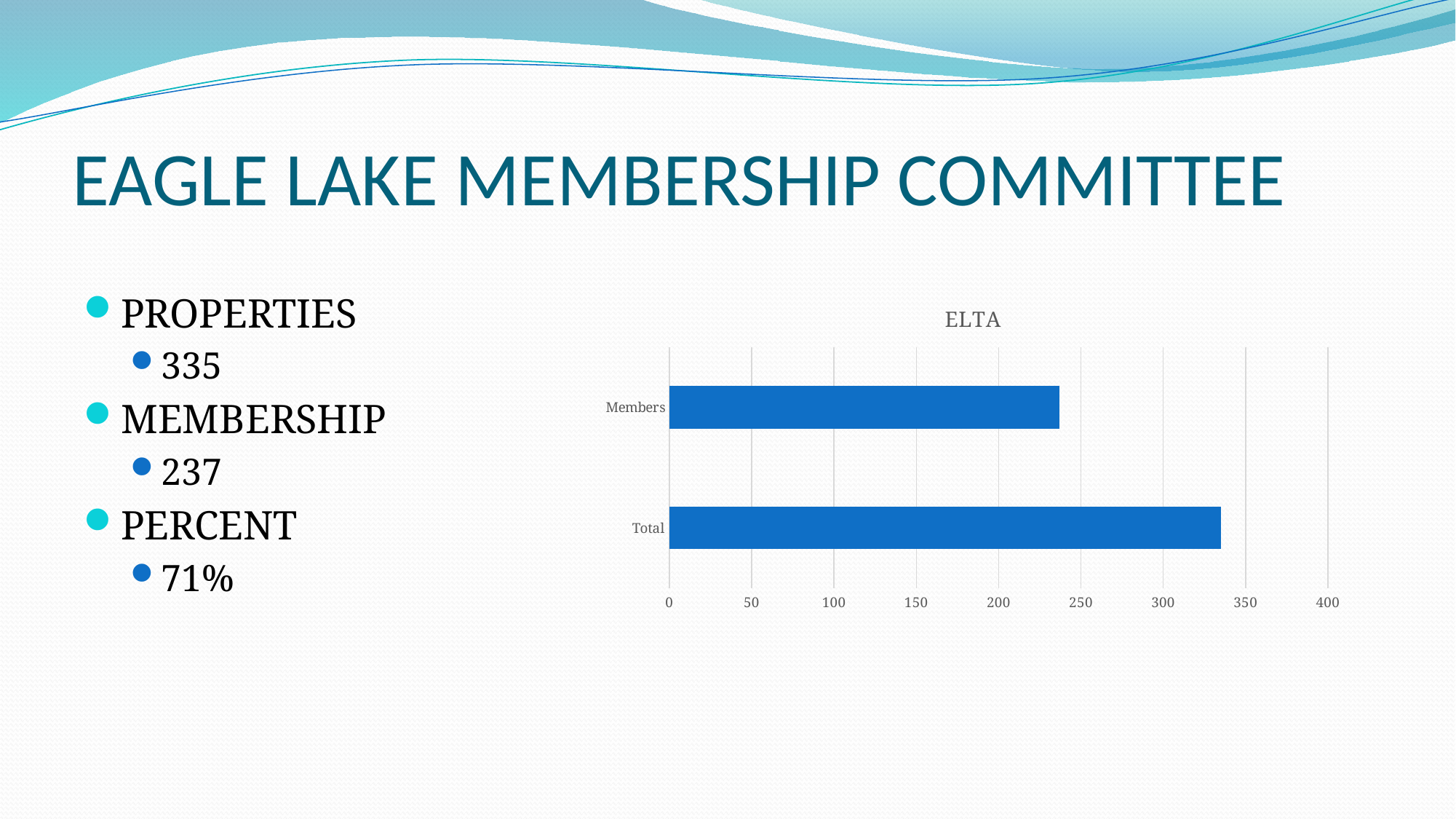
Is the value for Total greater or less than 300? greater Is the value for Members greater or less than 200? greater What kind of chart is shown on the slide? bar chart What is the maximum value shown on the horizontal axis of the chart? 400 Is the value for Members greater or less than 250? less What is the title of the chart? ELTA How many categories does the chart show? 2 According to the slide text, what is the membership count plotted as the Members bar? 237 Which category has the longer bar, Members or Total? Total Which category has the lowest value in the chart? Members Which category has the highest value in the chart? Total